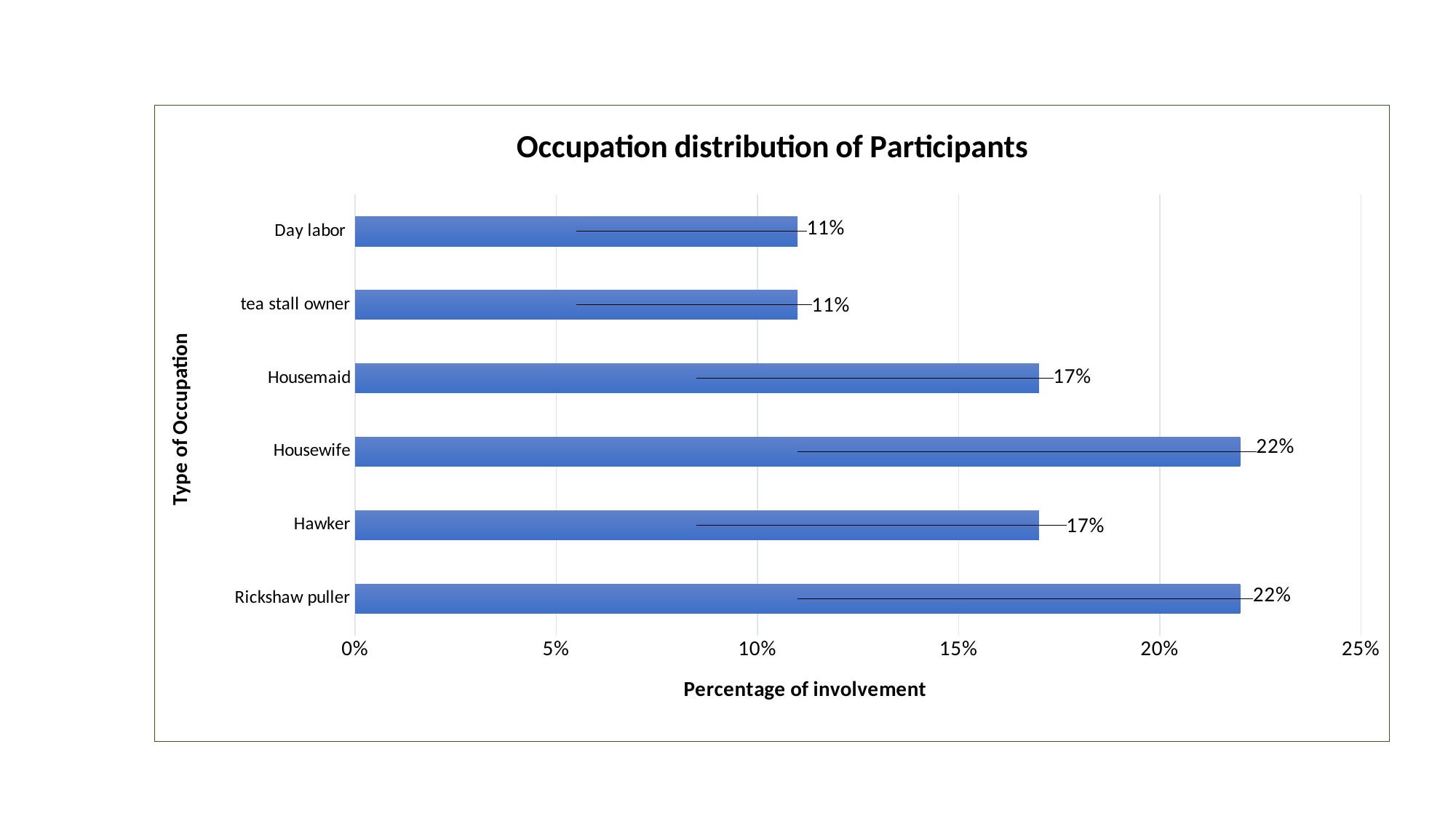
How many occupation categories are shown in the chart? 6 What is the difference between the percentage for Housemaid and the percentage for Day labor? 6% What is the percentage of involvement for Housemaid? 17% What is the percentage of involvement for Rickshaw puller? 22% What is the percentage of involvement for tea stall owner? 11% What kind of chart is shown on the slide? Bar chart Which occupations have the lowest percentage of involvement? Day labor and tea stall owner What is the title of the chart? Occupation distribution of Participants Is the value for Hawker greater or less than 15%? greater What is the difference between the percentage for Housewife and the percentage for Hawker? 5% What is the percentage of involvement for Day labor? 11% Which is larger, the percentage for Housewife or the percentage for Housemaid? Housewife